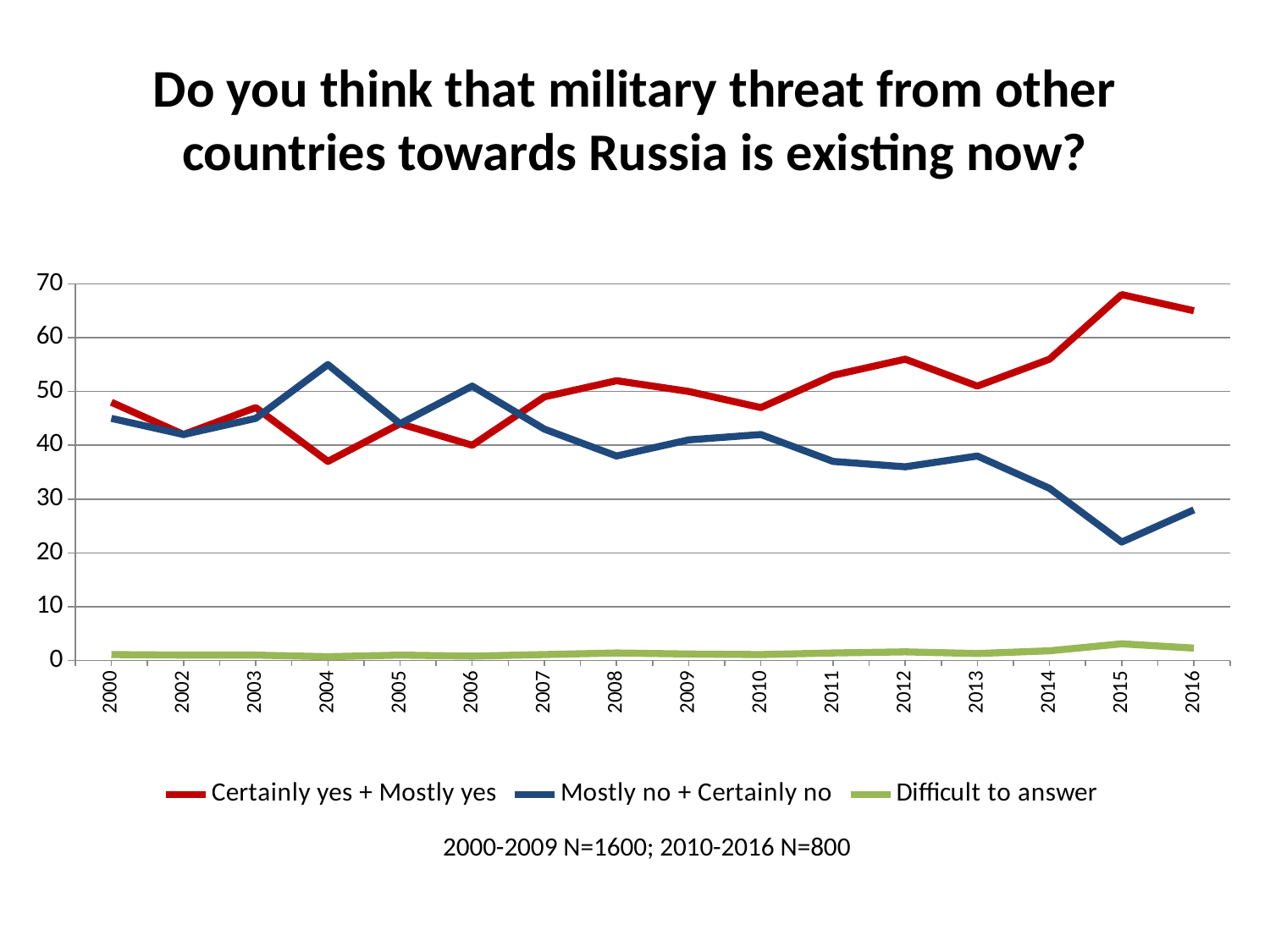
Is the value for 'Certainly yes + Mostly yes' in 2015 greater or less than 60? greater Is the value for 'Mostly no + Certainly no' in 2004 greater or less than 50? greater How many years are shown on the x axis? 16 Which series is drawn in green? Difficult to answer In which year does the 'Certainly yes + Mostly yes' series reach its highest value? 2015 In which year does the 'Mostly no + Certainly no' series reach its lowest value? 2015 How many series does the legend list? 3 Does the 'Mostly no + Certainly no' series generally rise or fall from 2010 to 2015? fall Is the value for 'Certainly yes + Mostly yes' in 2004 greater or less than 40? less What kind of chart is shown on the slide? line chart In 2004, which series is larger: 'Certainly yes + Mostly yes' or 'Mostly no + Certainly no'? Mostly no + Certainly no